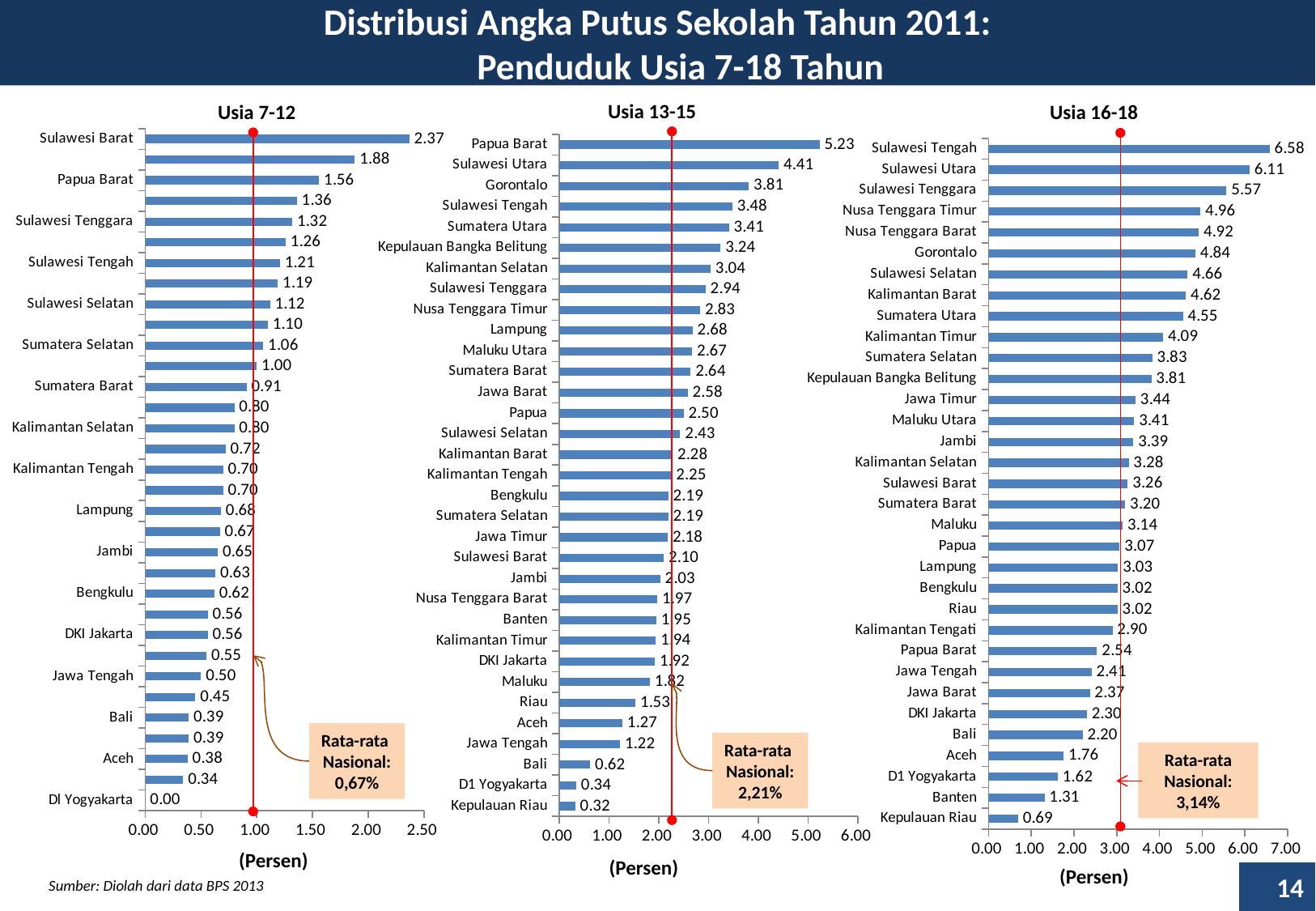
In the Usia 16-18 chart, what is the value for Sulawesi Tengah? 6.58 In the Usia 13-15 chart, which province has the highest value? Papua Barat In the Usia 7-12 chart, what is the value for Sulawesi Barat? 2.37 In the Usia 13-15 chart, what is the difference between the values for Papua Barat and Sulawesi Utara? 0.82 In the Usia 16-18 chart, what is the difference between the values for Sulawesi Tengah and Sulawesi Utara? 0.47 What kind of chart is the Usia 13-15 chart? bar chart In the Usia 7-12 chart, which province has the lowest value? DI Yogyakarta In the Usia 13-15 chart, which is larger, the value for Aceh or the value for Riau? Riau In the Usia 13-15 chart, what is the national average (Rata-rata Nasional) shown? 2,21% In the Usia 13-15 chart, what is the value for Gorontalo? 3.81 In the Usia 16-18 chart, which province has the lowest value? Kepulauan Riau In the Usia 16-18 chart, is the value for Aceh greater or less than 2.00? less